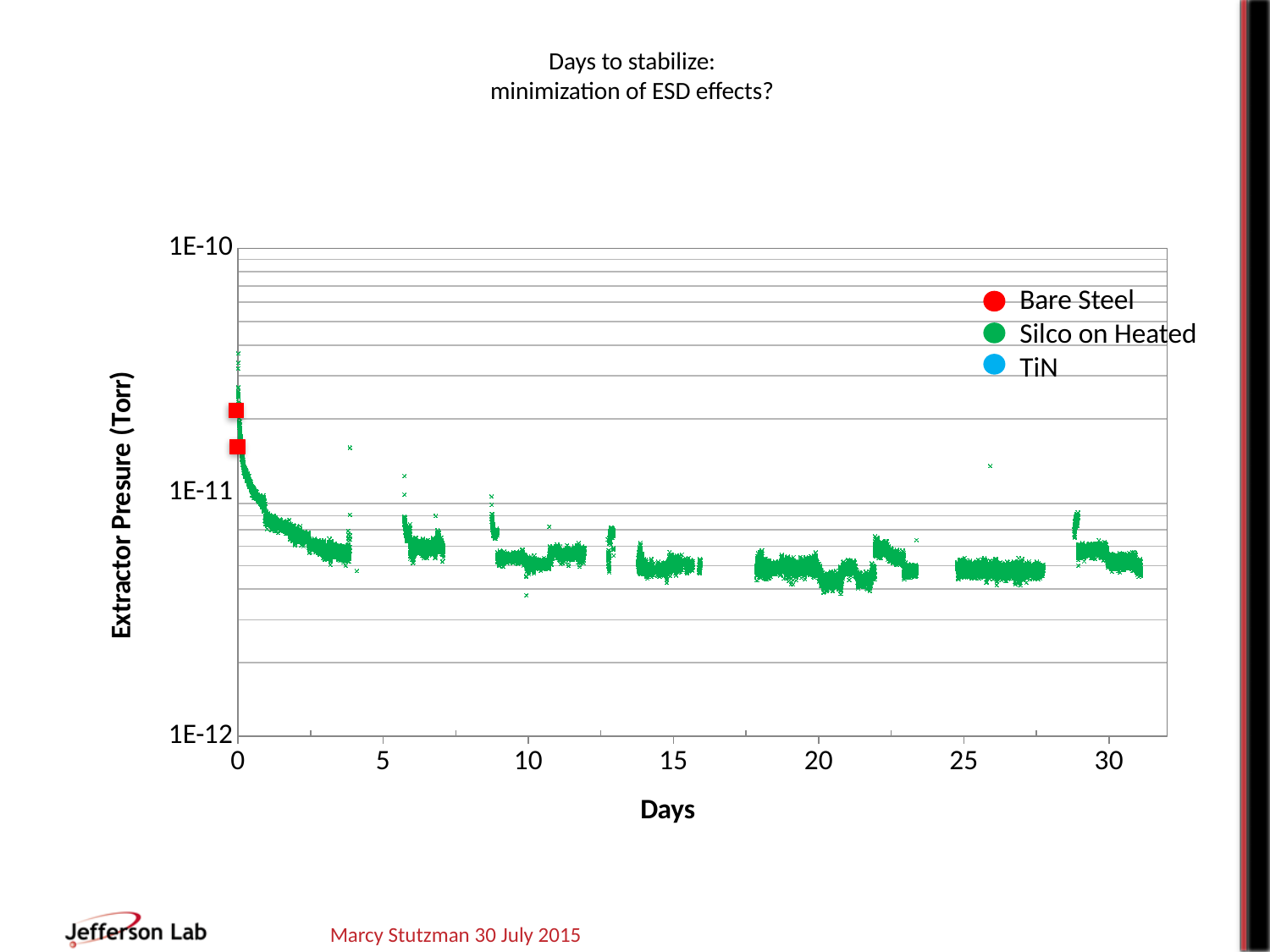
Is the value for Silco on Heated at day 20 greater or less than 1E-12? greater Do the Silco on Heated values rise or fall as the number of days increases? fall Is the value for Bare Steel at day 0 greater or less than 1E-11? greater What is the label of the y axis? Extractor Presure (Torr) Which series has the highest plotted value on the chart? Silco on Heated What is the highest tick value shown on the y axis? 1E-10 Is the value for Silco on Heated at day 30 greater or less than 1E-11? less Which is larger: the Bare Steel value at day 0 or the Silco on Heated value at day 25? Bare Steel at day 0 What kind of chart is shown on the slide? scatter chart What is the label of the x axis? Days How many series does the legend list? 3